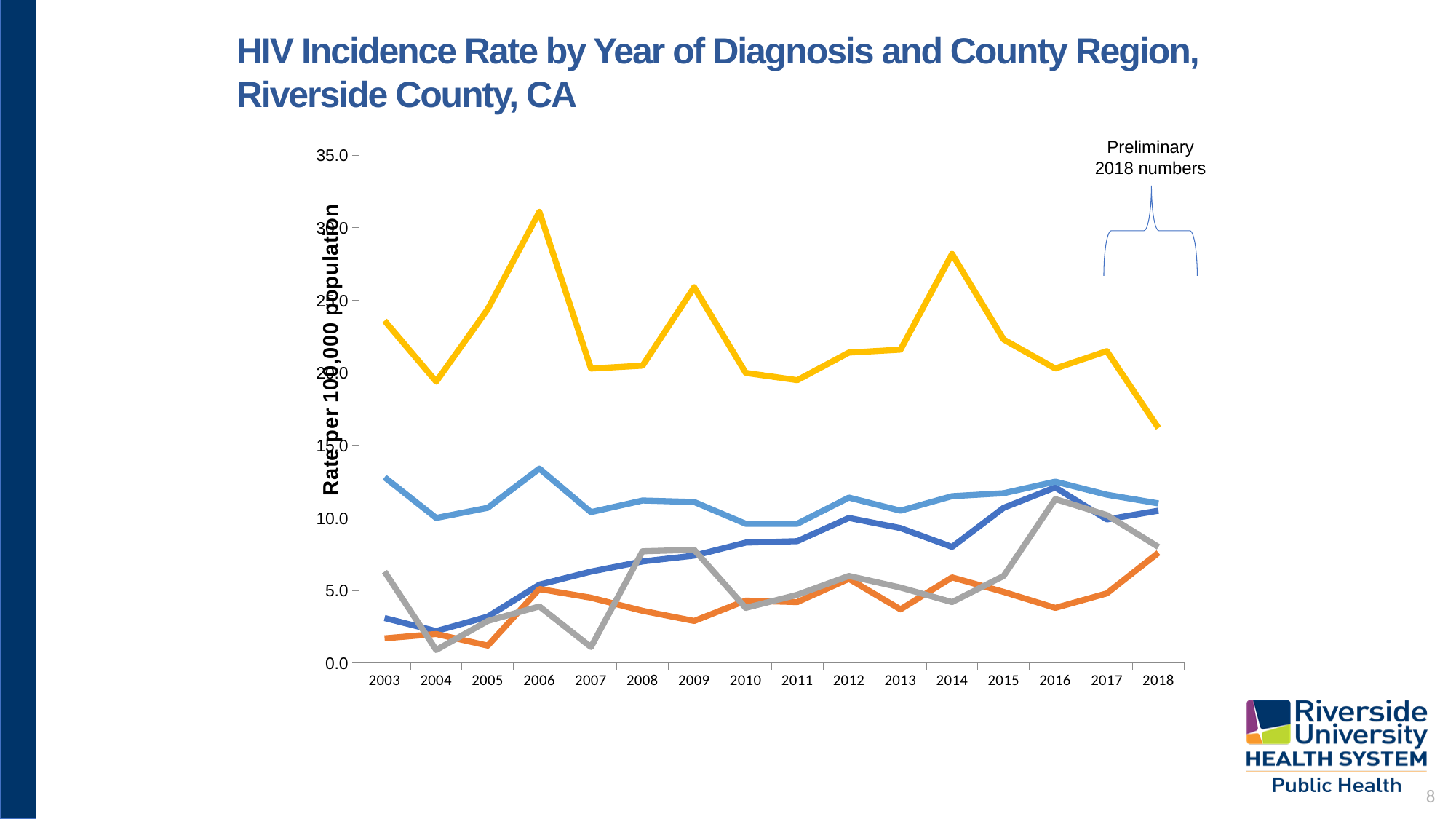
Is the value of the yellow line in 2018 greater or less than 20? less What is the label on the vertical axis of the chart? Rate per 100,000 population Is the value of the yellow line in 2006 greater or less than 25? greater In which year does the yellow line reach its lowest value? 2018 In which year does the yellow line reach its highest value? 2006 How many years are plotted along the x axis of the chart? 16 Is the value of the light blue line in 2003 greater or less than 10? greater What is the title of the chart on the slide? HIV Incidence Rate by Year of Diagnosis and County Region, Riverside County, CA Which line has the higher value in 2016, the yellow line or the orange line? yellow Does the yellow line rise or fall from 2017 to 2018? fall What kind of chart is shown on the slide? line chart